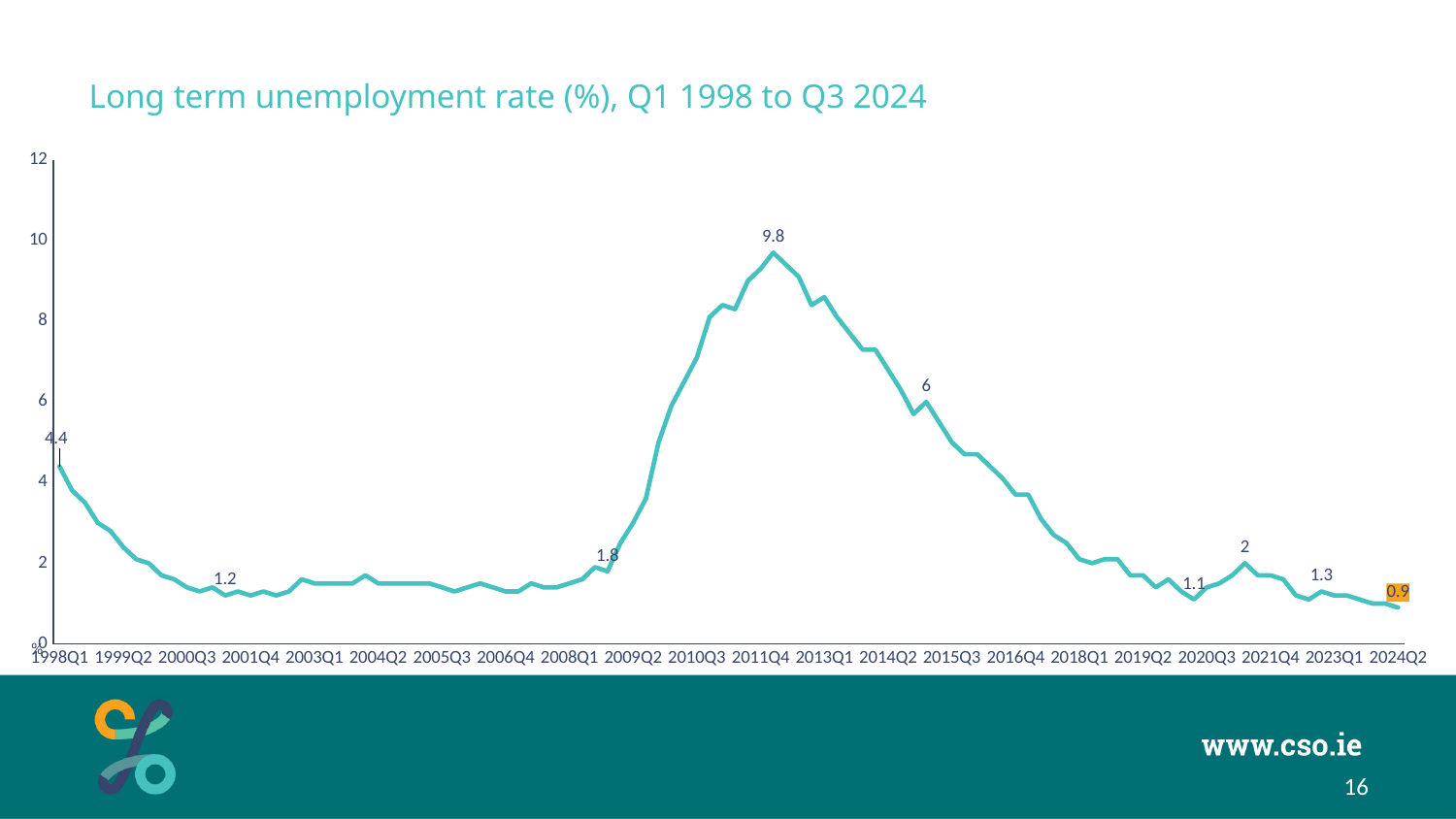
What is the difference between the peak value of 9.8 and the final value of 0.9? 8.9 What is the long term unemployment rate at the start of the series, Q1 1998? 4.4 What kind of chart is shown on the slide? line chart What is the title of the chart? Long term unemployment rate (%), Q1 1998 to Q3 2024 Is the value for 2005Q3 greater or less than 2? less What is the difference between the starting value in Q1 1998 and the final value in Q3 2024? 3.5 What is the long term unemployment rate at the end of the series, Q3 2024? 0.9 Does the long term unemployment rate rise or fall from its peak to the end of the series? fall What is the highest value reached by the long term unemployment rate on the chart? 9.8 What is the lowest labelled value on the chart? 0.9 Is the value for 2010Q3 greater or less than 6? greater Which is larger, the rate in Q1 1998 or the rate in Q3 2024? Q1 1998